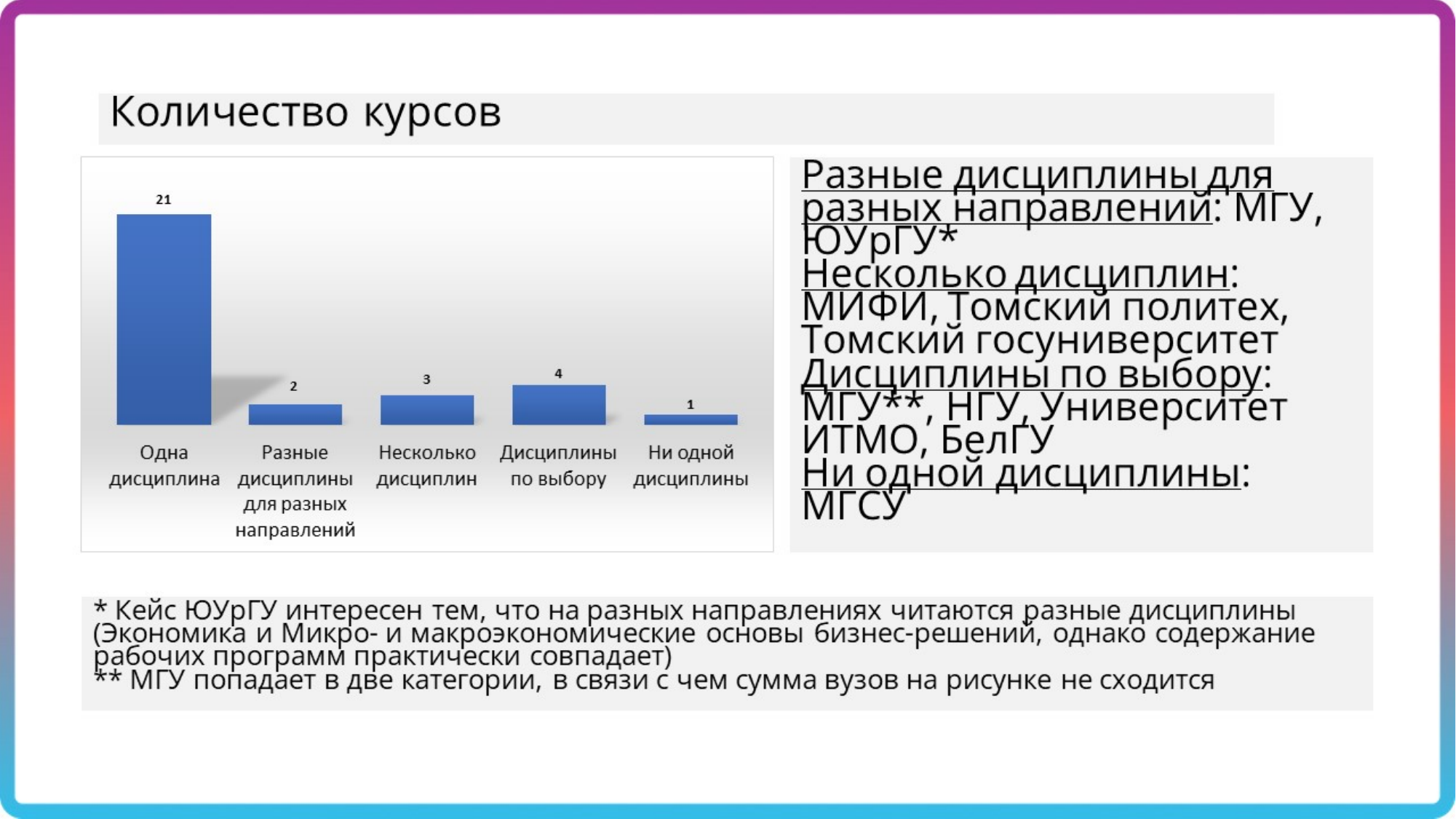
What is the title of the slide containing the chart? Количество курсов What kind of chart is shown on the slide? Bar chart What is the value for "Несколько дисциплин"? 3 What is the value for "Ни одной дисциплины"? 1 Which is larger: the value for "Несколько дисциплин" or the value for "Дисциплины по выбору"? Дисциплины по выбору Which category has the highest value? Одна дисциплина What is the difference between the values for "Одна дисциплина" and "Дисциплины по выбору"? 17 How many categories are shown in the chart? 5 Which category has the lowest value? Ни одной дисциплины What is the value for "Одна дисциплина"? 21 What is the value for "Дисциплины по выбору"? 4 What is the value for "Разные дисциплины для разных направлений"? 2